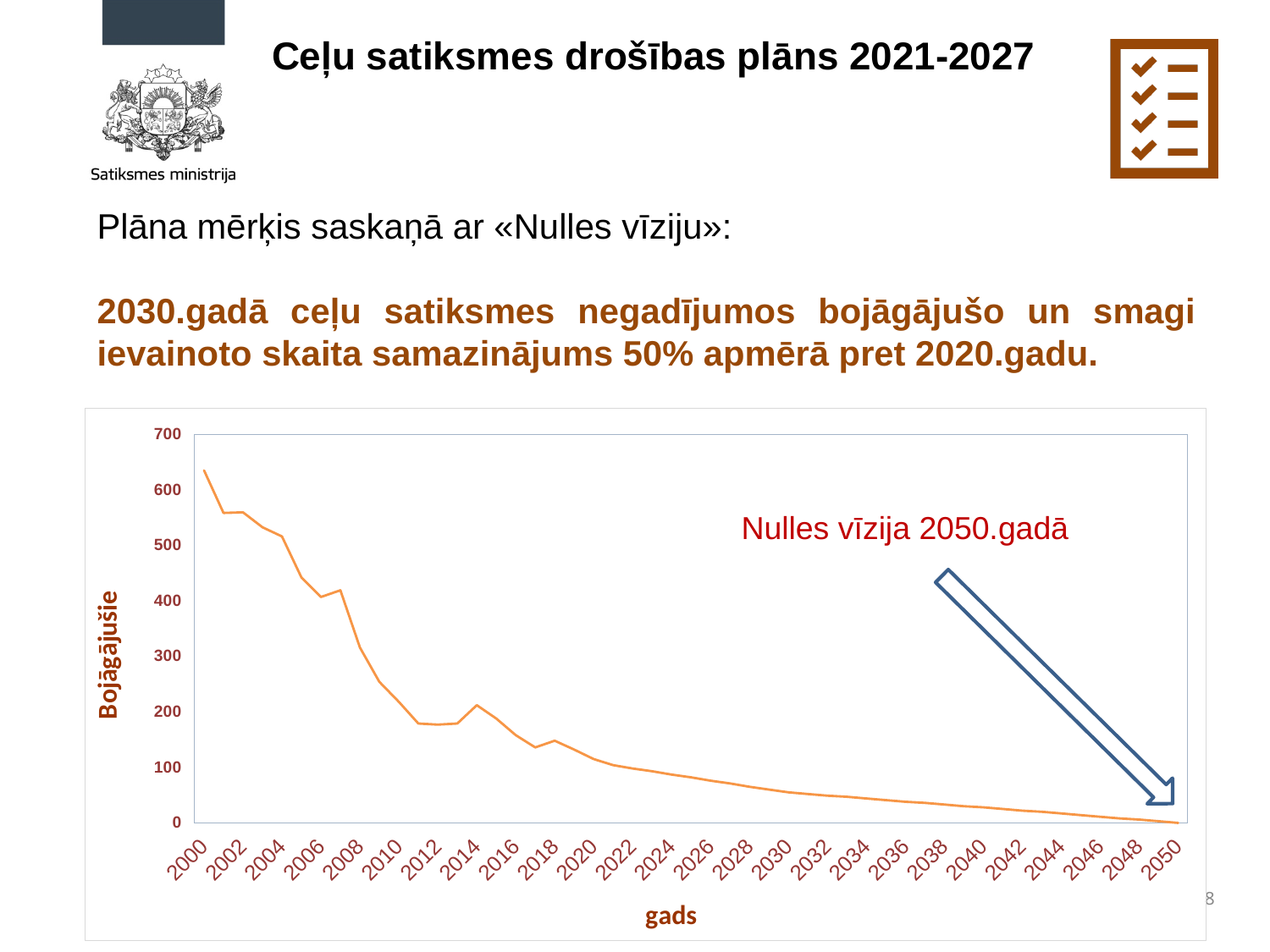
Is the value for 2000 greater or less than 600? greater Is the value for 2010 greater or less than 300? less Which year has the lowest value on the chart? 2050 What kind of chart is shown on the slide? line chart Is the value for 2004 greater or less than 500? greater Which year has the highest value on the chart? 2000 What is the title of the vertical axis of the chart? Bojāgājušie Do the values on the chart rise or fall from 2000 to 2050? fall Which year has the larger value, 2000 or 2010? 2000 What is the title of the horizontal axis of the chart? gads